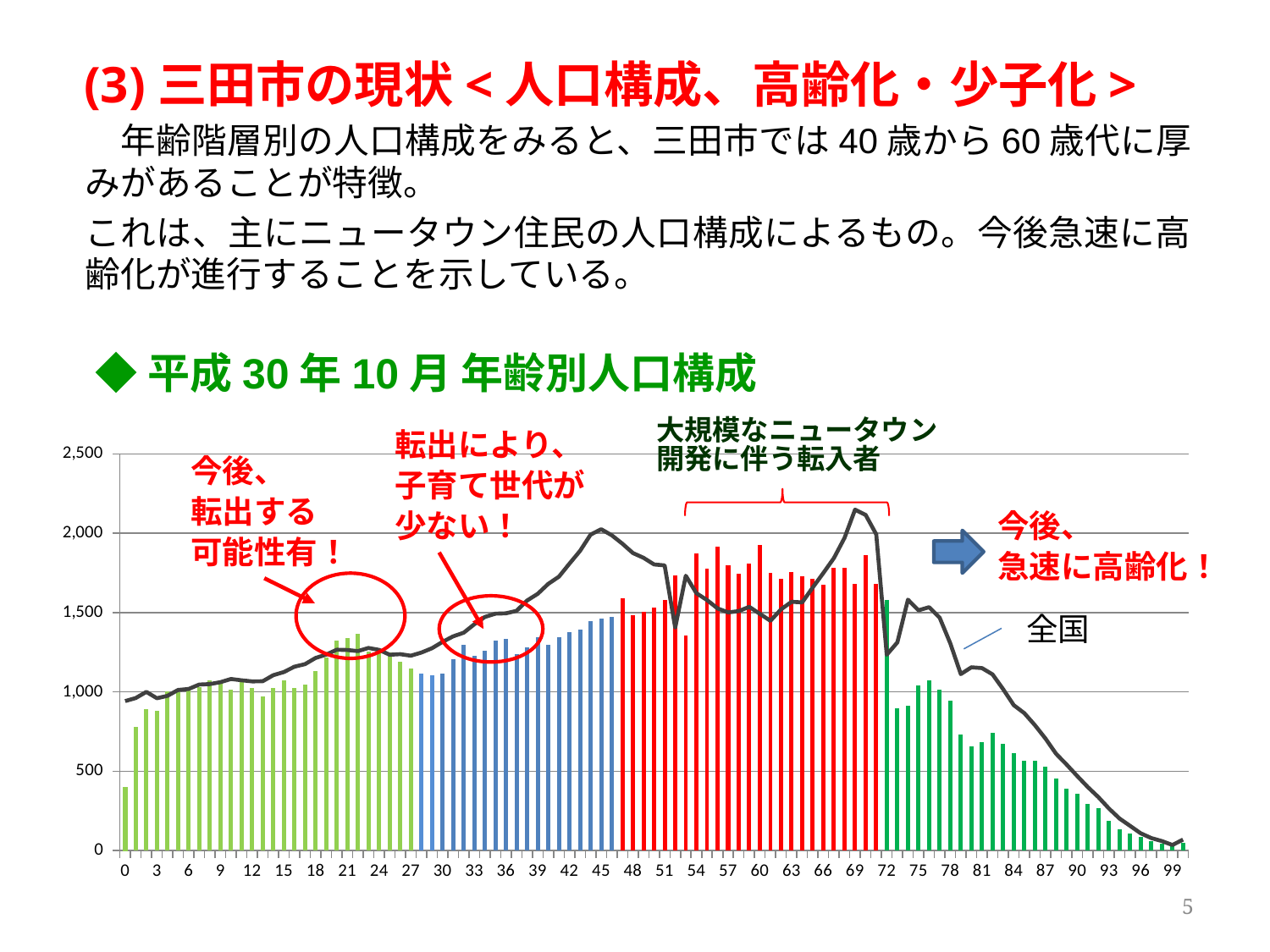
Is the bar value for age 78 greater or less than 1,000? less What does the dark line plotted over the bars represent, according to its label? 全国 Is the 全国 line value at age 45 greater or less than 1,500? greater Do the bar values rise or fall as age increases from 72 to 99? fall What is the title of the chart on this slide? 平成30年10月 年齢別人口構成 Is the bar value for age 60 greater or less than 1,500? greater Which has the taller bar, age 30 or age 90? age 30 What kind of chart is used to show the age-specific population on this slide? combination bar and line chart Which has the taller bar, age 0 or age 60? age 60